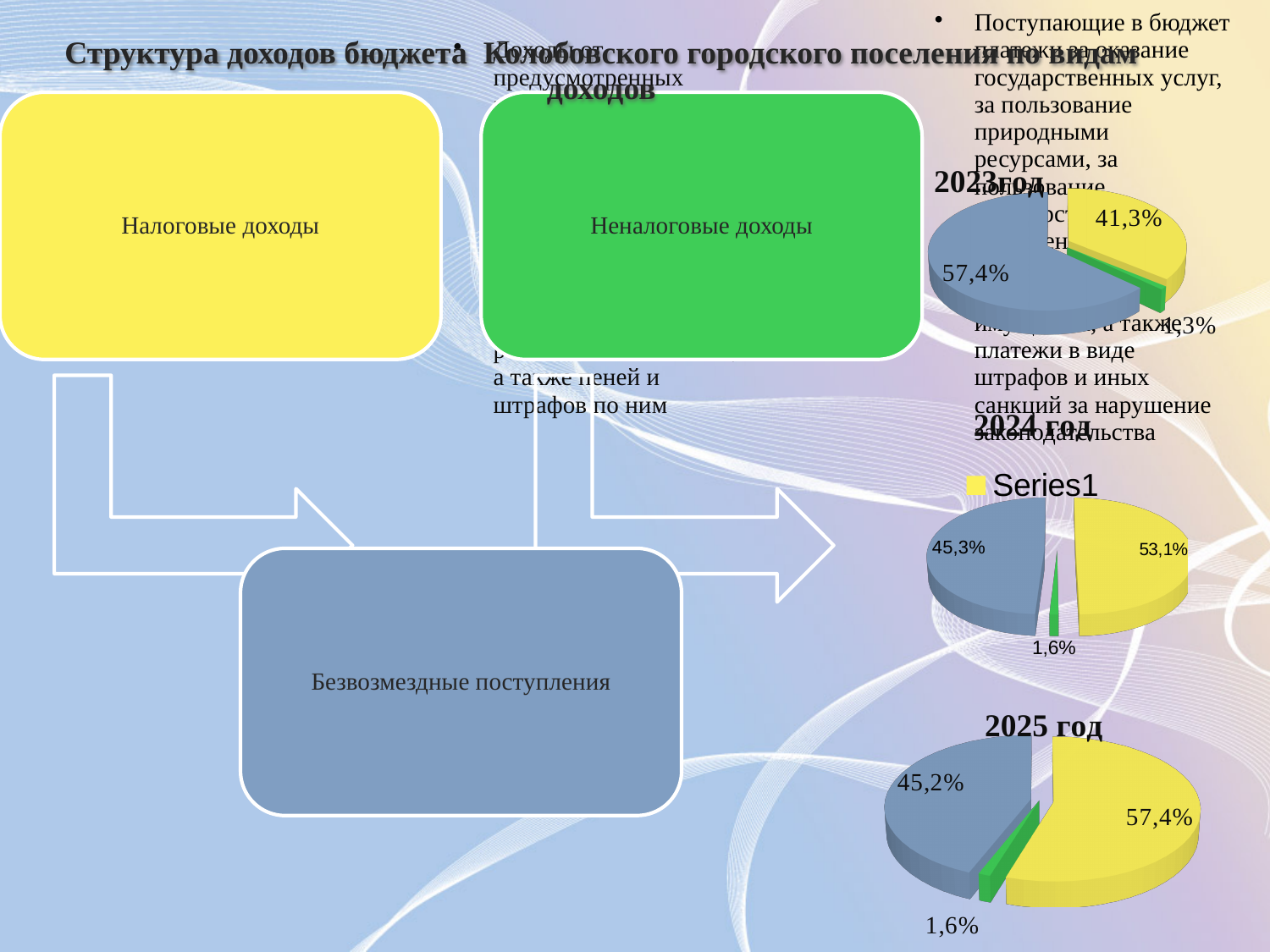
In the 2023 год pie chart, what is the value of the green slice? 1,3% How many pie charts are on the slide? 3 In the 2023 год pie chart, what is the value of the blue slice? 57,4% What legend entry is shown above the 2024 год pie chart? Series1 What kind of chart is used for the 2023 год, 2024 год and 2025 год data? pie chart In the 2025 год pie chart, what is the value of the largest slice? 57,4% In the 2024 год pie chart, what is the value of the smallest slice? 1,6% In the 2023 год pie chart, what is the value of the yellow slice? 41,3% In the 2024 год pie chart, what is the value of the yellow slice? 53,1% In the 2024 год pie chart, what is the difference between the yellow slice (53,1%) and the blue slice (45,3%)? 7,8% In the 2025 год pie chart, what is the value of the blue slice? 45,2% How many slices does each pie chart have? 3